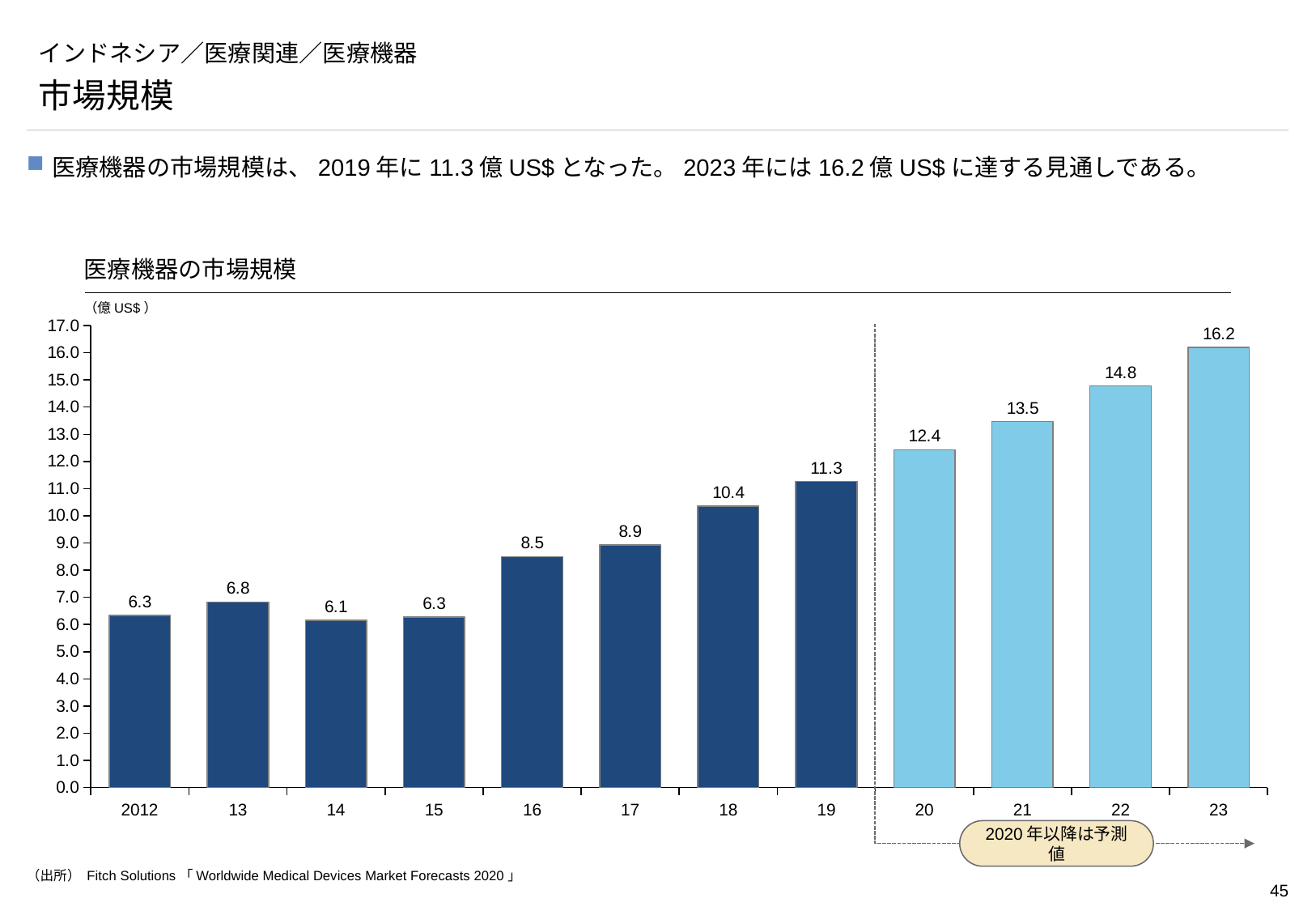
Which year has the lowest value in the chart? 14 Which is larger, the value for 2016 or the value for 2017? 17 What is the difference between the values for 2023 and 2019? 4.9 What kind of chart is shown on the slide? bar chart How many years are plotted in the chart? 12 What is the value shown for 2014? 6.1 What is the market size value shown for 2019? 11.3 What is the value shown for 2023? 16.2 Which year has the highest value in the chart? 23 Do the values generally rise or fall from 2015 to 2023? rise What is the title of the chart? 医療機器の市場規模 Is the value for 2020 greater or less than 12.0? greater